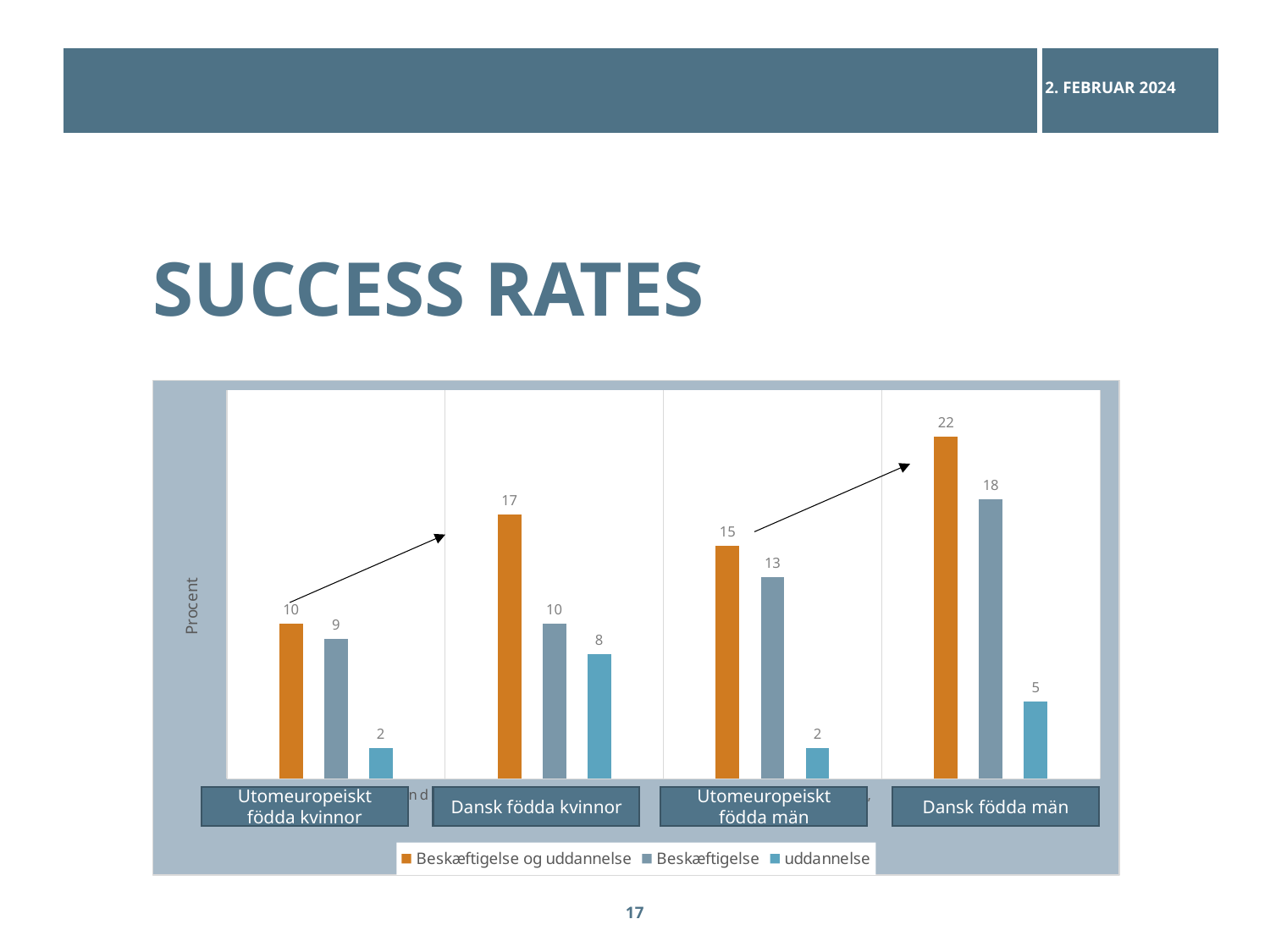
Which category has the lowest value for Beskæftigelse? Utomeuropeiskt födda kvinnor What is the value of Beskæftigelse for Utomeuropeiskt födda kvinnor? 9 Which is larger: the Beskæftigelse value for Dansk födda män or the Beskæftigelse og uddannelse value for Dansk födda kvinnor? Beskæftigelse for Dansk födda män Which category has the highest value for Beskæftigelse og uddannelse? Dansk födda män What is the label of the y axis? Procent How many categories are shown on the x axis? 4 What is the difference between the Beskæftigelse og uddannelse values for Dansk födda kvinnor and Utomeuropeiskt födda kvinnor? 7 What is the value of uddannelse for Dansk födda kvinnor? 8 What is the value of Beskæftigelse og uddannelse for Dansk födda män? 22 How many series does the legend list? 3 What kind of chart is shown on the slide? Bar chart What is the value of Beskæftigelse for Utomeuropeiskt födda män? 13